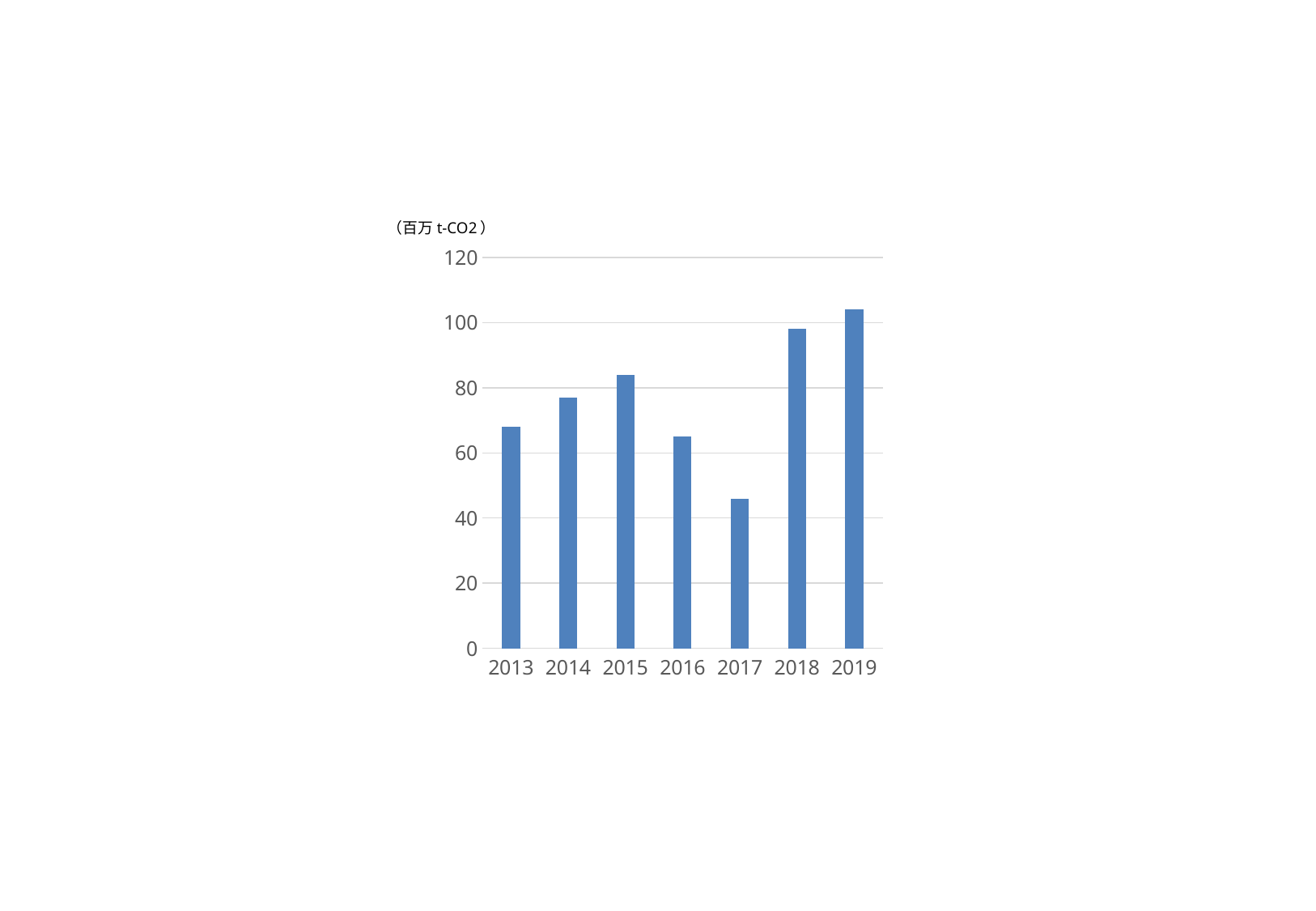
Is the value for 2016 greater or less than 80? less Which is larger, the value for 2018 or the value for 2016? 2018 What kind of chart is shown on the slide? bar chart Which year has the lowest bar in the chart? 2017 Which is larger, the value for 2015 or the value for 2014? 2015 Which year has the highest bar in the chart? 2019 Is the value for 2017 greater or less than 60? less What unit label is printed above the vertical axis of the chart? （百万 t-CO2） How many years are shown on the x axis of the chart? 7 Is the value for 2017 greater or less than 40? greater